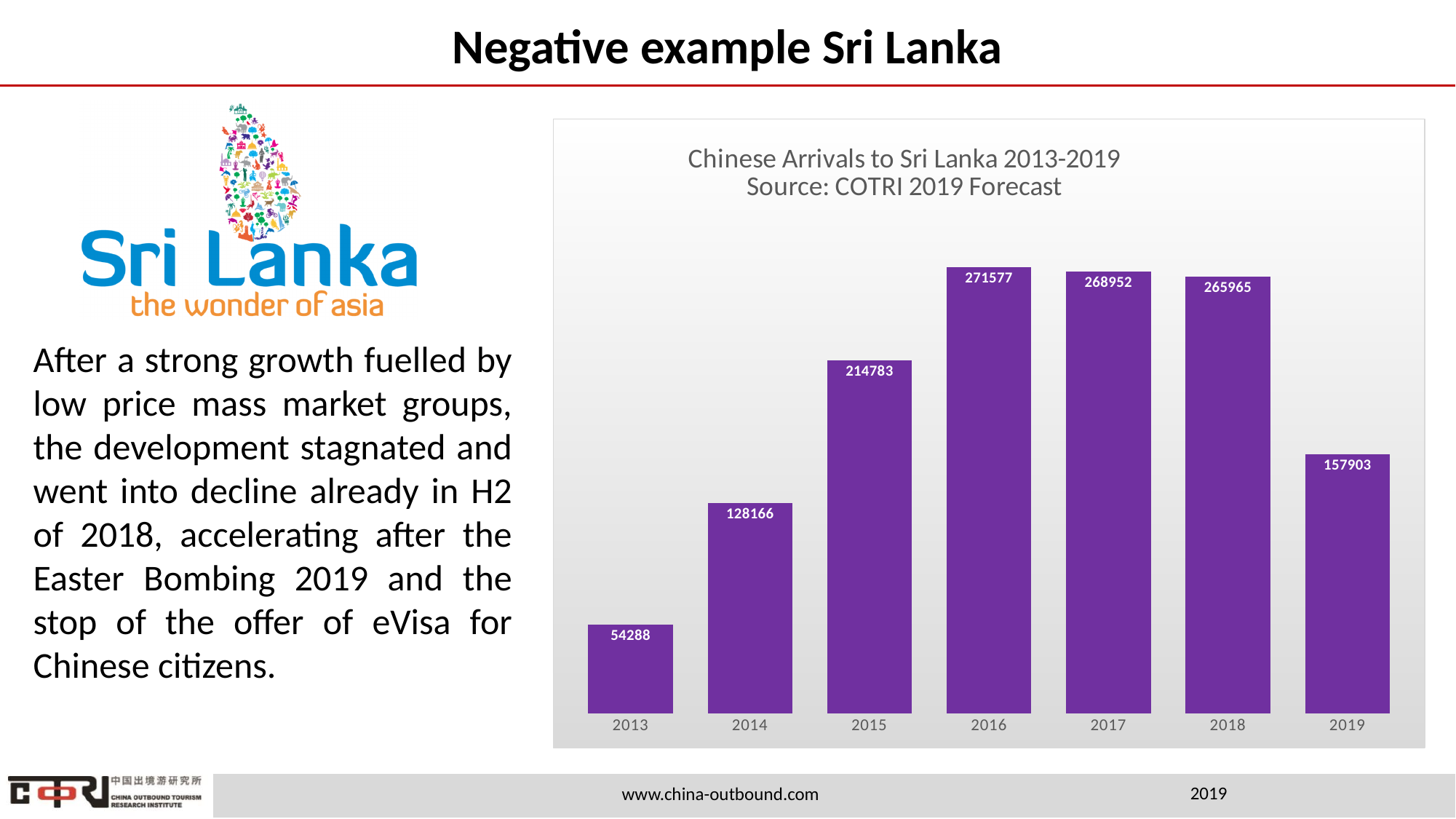
Which year has the highest value in the Chinese Arrivals to Sri Lanka chart? 2016 What is the value for 2016 in the Chinese Arrivals to Sri Lanka chart? 271577 Do the values in the Chinese Arrivals to Sri Lanka chart rise or fall from 2016 to 2019? fall Which is larger in the Chinese Arrivals to Sri Lanka chart, the value for 2015 or the value for 2019? 2015 What is the value for 2019 in the Chinese Arrivals to Sri Lanka chart? 157903 What is the value for 2013 in the Chinese Arrivals to Sri Lanka chart? 54288 What is the difference between the values for 2014 and 2013 in the Chinese Arrivals to Sri Lanka chart? 73878 What is the difference between the values for 2018 and 2019 in the Chinese Arrivals to Sri Lanka chart? 108062 What kind of chart is the Chinese Arrivals to Sri Lanka chart? bar chart How many years are shown in the Chinese Arrivals to Sri Lanka chart? 7 Which year has the lowest value in the Chinese Arrivals to Sri Lanka chart? 2013 What source is given in the title of the Chinese Arrivals to Sri Lanka chart? COTRI 2019 Forecast